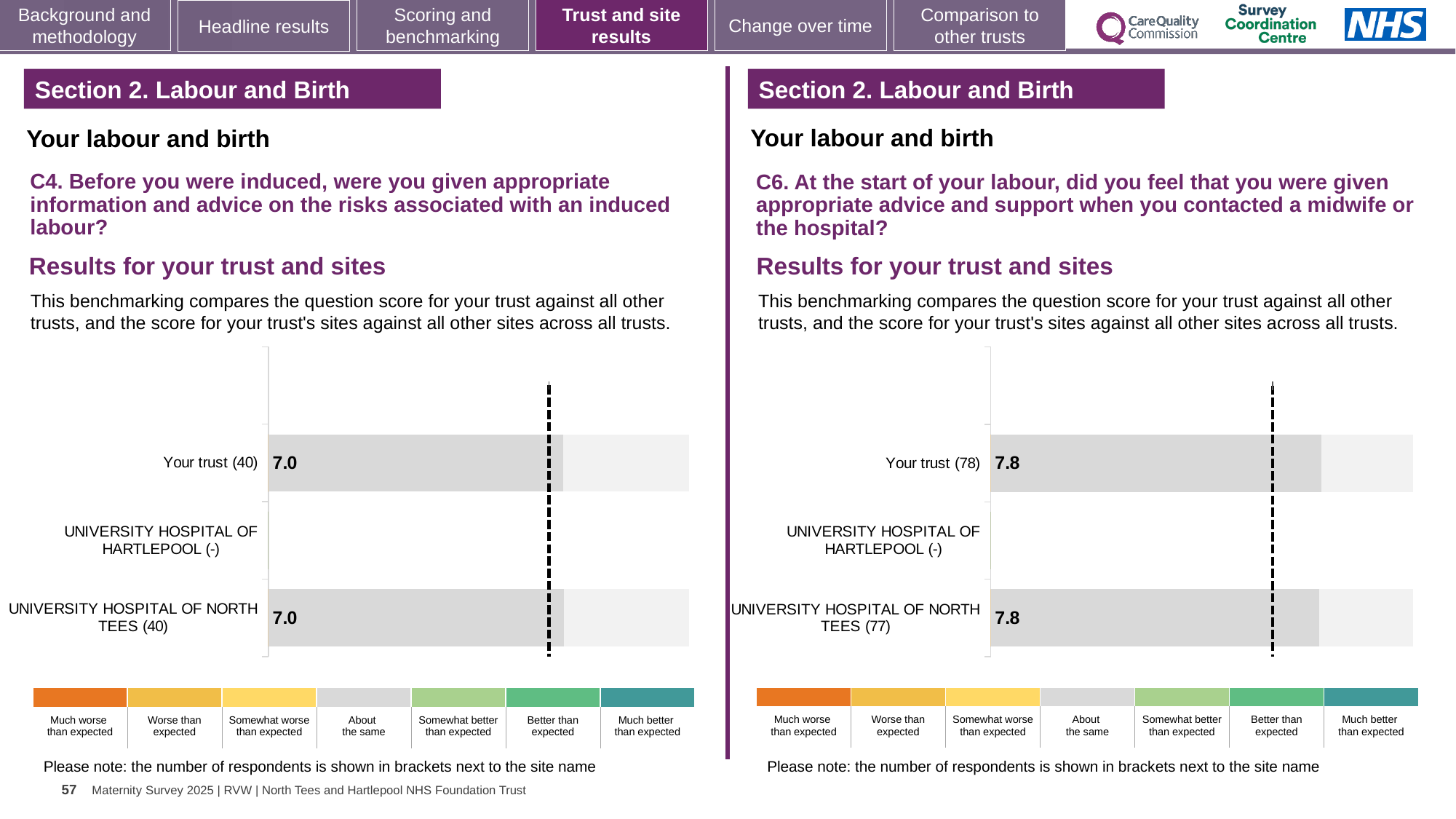
On the right chart (C6), what is the difference between the score for Your trust and the score for University Hospital of North Tees? 0.0 On the right chart (C6), how many respondents are shown in brackets for University Hospital of North Tees? 77 Is the score for Your trust on the right chart (C6) greater or less than the score for Your trust on the left chart (C4)? greater On the left chart (C4), what is the score for Your trust? 7.0 On the left chart (C4), how many respondents are shown in brackets for Your trust? 40 How many site/trust categories are listed on the left chart (C4)? 3 How many benchmark categories does the colour key below the right chart (C6) list? 7 On the left chart (C4), what is the score for University Hospital of North Tees? 7.0 What kind of chart is used on the right (C6) to show the results for your trust and sites? Bar chart On the right chart (C6), what is the score for University Hospital of North Tees? 7.8 On the right chart (C6), what is the score for Your trust? 7.8 On the left chart (C4), which category has no bar plotted? UNIVERSITY HOSPITAL OF HARTLEPOOL (-)